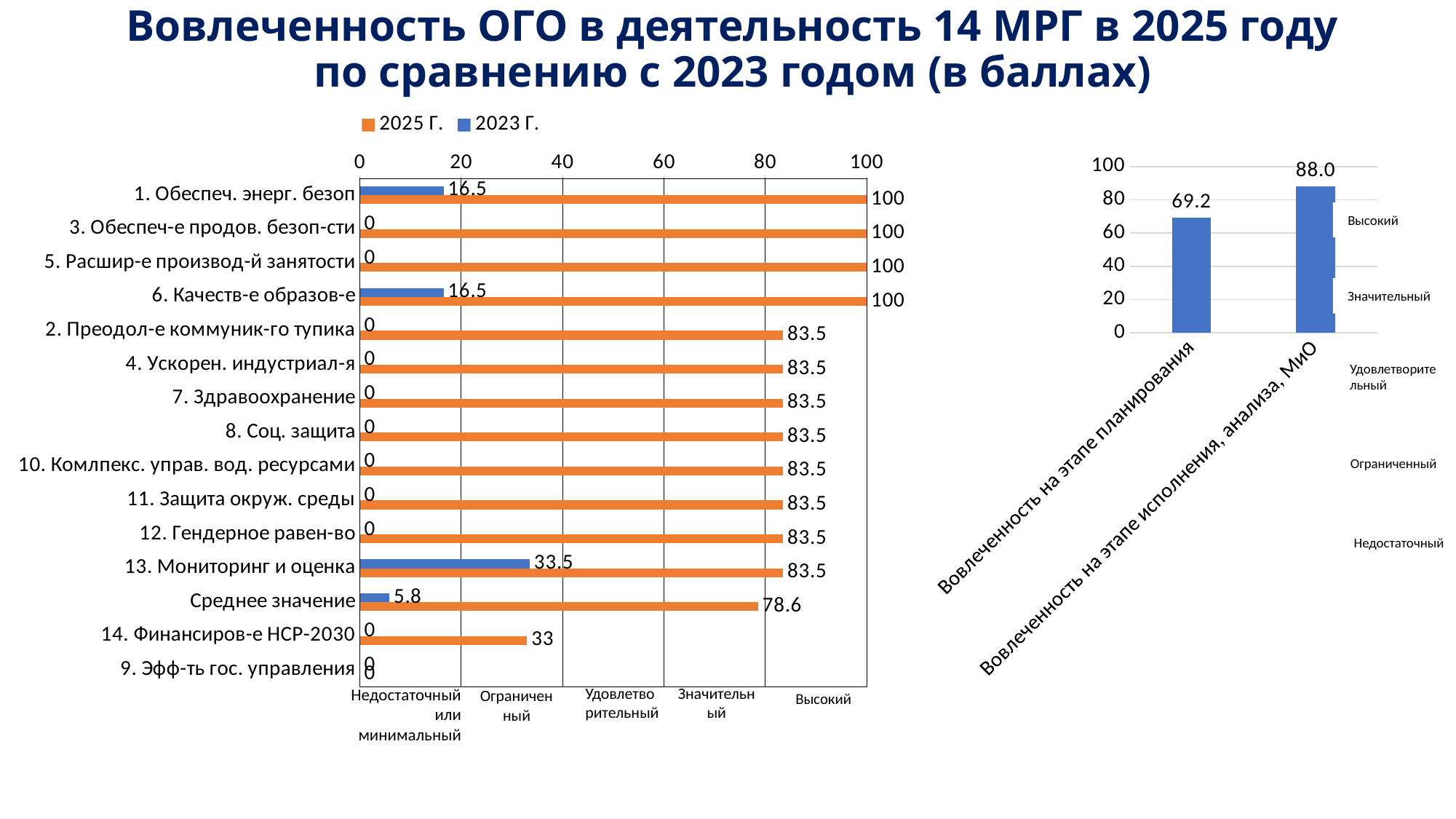
On the left chart, what is the 2025 г. value for 13. Мониторинг и оценка? 83.5 On the right chart, what is the difference between the two bars (88.0 and 69.2)? 18.8 On the left chart, how many categories are shown on the vertical axis? 15 On the left chart, what is the 2023 г. value for 13. Мониторинг и оценка? 33.5 On the left chart, what is the 2023 г. value for 1. Обеспеч. энерг. безоп? 16.5 On the left chart, what is the difference between the 2025 г. and 2023 г. values for Среднее значение? 72.8 What type of chart is the chart on the left? Bar chart On the left chart, which category has the highest 2023 г. value? 13. Мониторинг и оценка On the left chart, what is the 2025 г. value for 14. Финансиров-е НСР-2030? 33 On the left chart, what is the 2025 г. value for Среднее значение? 78.6 On the right chart, what is the value for Вовлеченность на этапе исполнения, анализа, МиО? 88.0 On the left chart, how many series does the legend list? 2